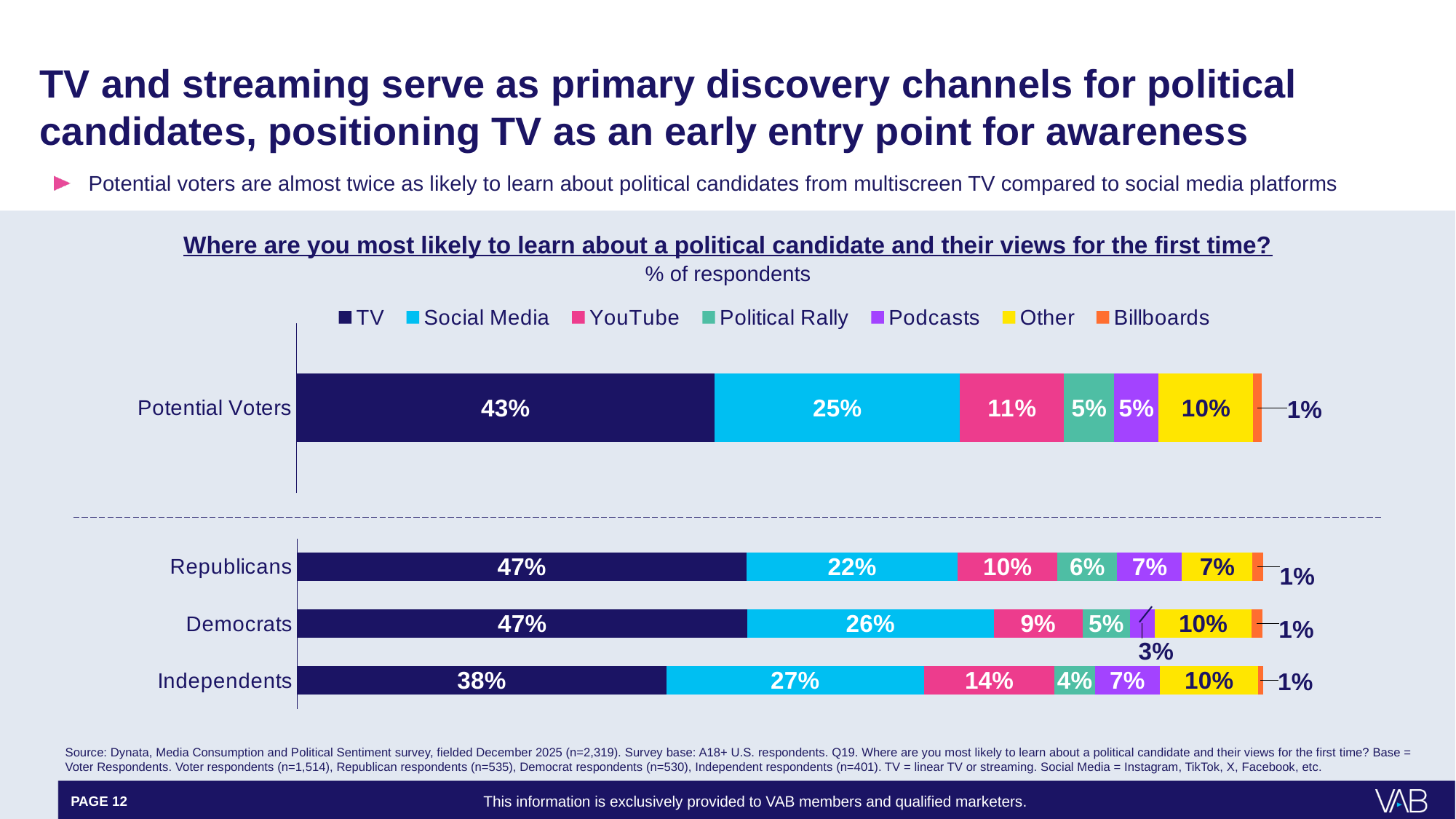
What kind of chart is shown on the slide? Stacked bar chart How many groups (bars) are shown in the chart? 4 Is the Social Media value larger for Democrats or for Republicans? Democrats Which group has the lowest TV value? Independents What is the difference between the TV value and the Social Media value for Potential Voters? 18% What is the Social Media value for Independents? 27% Which group has the highest YouTube value? Independents How many series does the legend list? 7 What is the Podcasts value for Democrats? 3% What percentage of Potential Voters say they are most likely to learn about a political candidate from TV? 43% Which series is shown in yellow in the legend? Other What is the YouTube value for Republicans? 10%